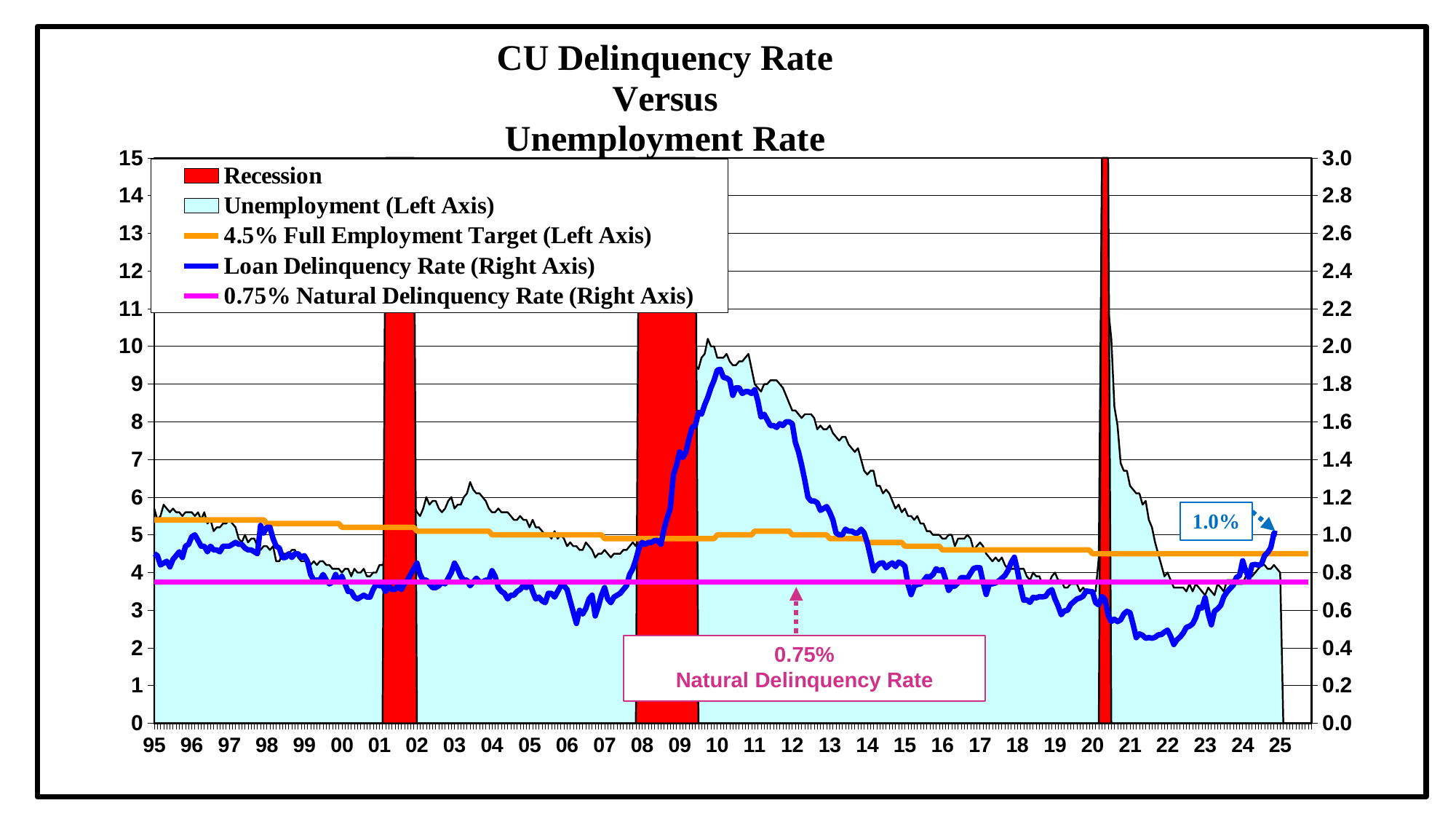
Is the Loan Delinquency Rate at its 2010 peak greater or less than 1.6 on the right axis? greater What is the title of the chart? CU Delinquency Rate Versus Unemployment Rate Does the Loan Delinquency Rate rise or fall from 2022 to 2025? rise What is the Natural Delinquency Rate shown on the chart? 0.75% How many entries does the legend list? 5 Around which year does the Loan Delinquency Rate reach its lowest point? 22 Is the Unemployment value at its 2020 peak greater or less than 12 on the left axis? greater Is the Loan Delinquency Rate in 2022 greater or less than 0.6 on the right axis? less Which is larger, the Unemployment value in 2010 or in 2000? 2010 In which year does the Unemployment series reach its highest point? 20 What is the labeled value of the Loan Delinquency Rate at the end of the series in 2025? 1.0% How many recession bands are shaded on the chart? 3